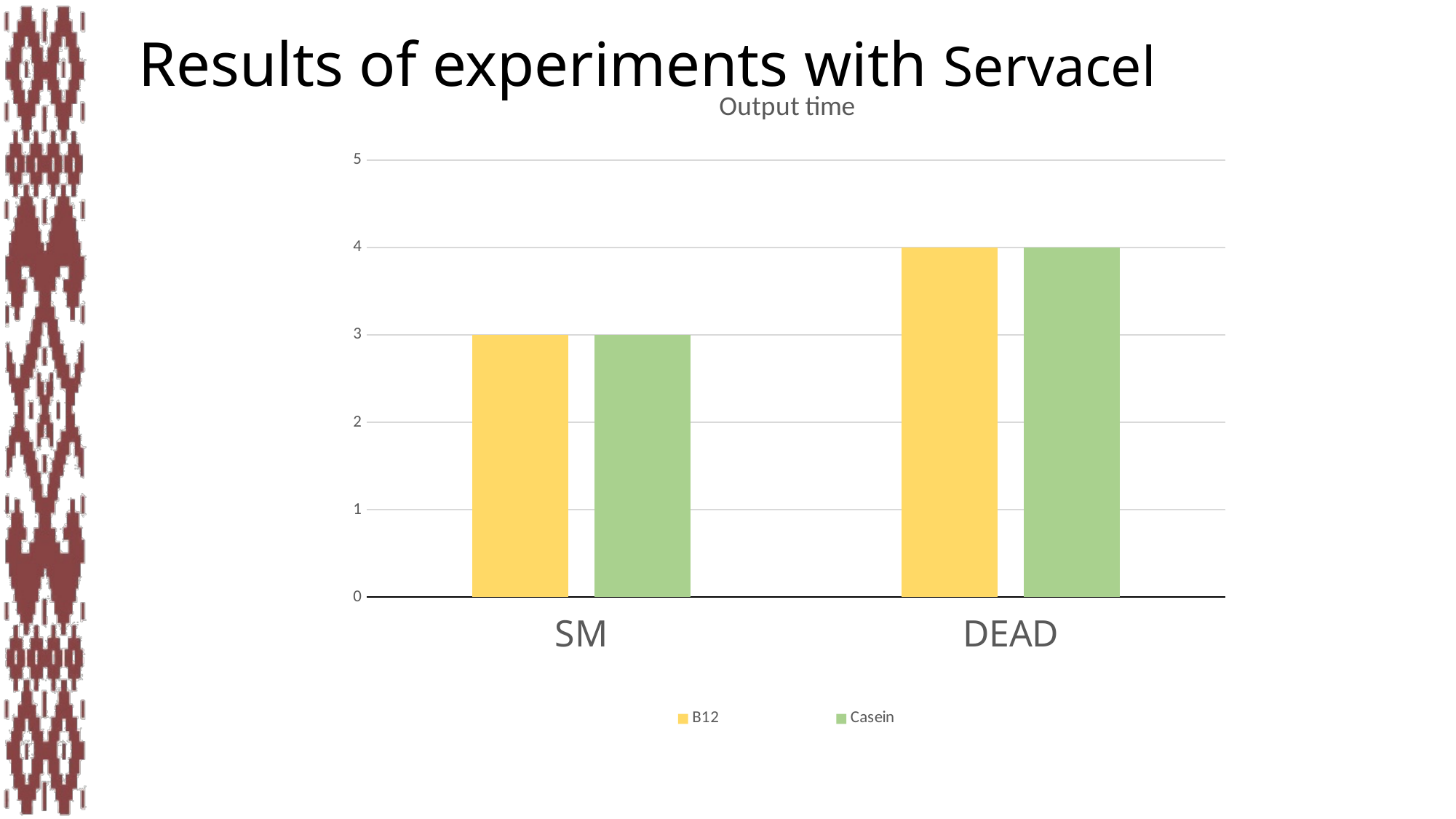
How many categories are shown on the x axis? 2 What is the difference between the B12 values for DEAD and SM? 1 What is the Casein value for SM? 3 What is the B12 value for SM? 3 What kind of chart is shown on the slide? bar chart Which series is shown in green in the legend? Casein Which category has the higher B12 value? DEAD What is the Casein value for DEAD? 4 How many series does the legend list? 2 Which category has the lower Casein value? SM What is the title of the chart? Output time What is the B12 value for DEAD? 4